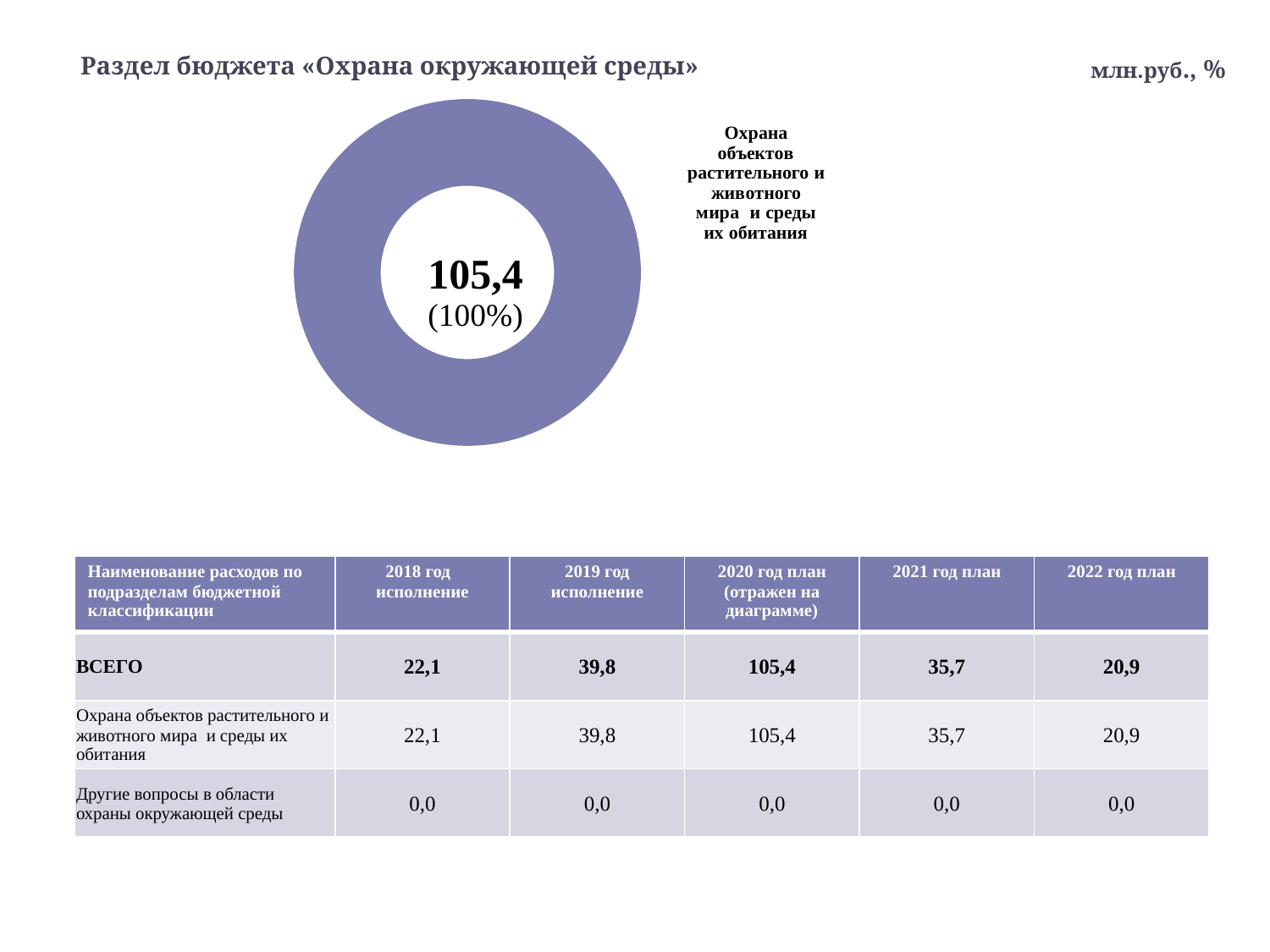
What units are indicated in the top right corner of the slide for the chart values? млн.руб., % What total value is printed in the centre of the donut chart? 105,4 What percentage is printed in the centre of the donut chart? 100% What kind of chart is shown on the slide? Pie (donut) chart How many slices does the donut chart contain? 1 What is the title of the slide containing the donut chart? Раздел бюджета «Охрана окружающей среды» What share of the donut chart does the slice «Охрана объектов растительного и животного мира и среды их обитания» represent? 100% What is the value of the slice «Охрана объектов растительного и животного мира и среды их обитания» in the donut chart? 105,4